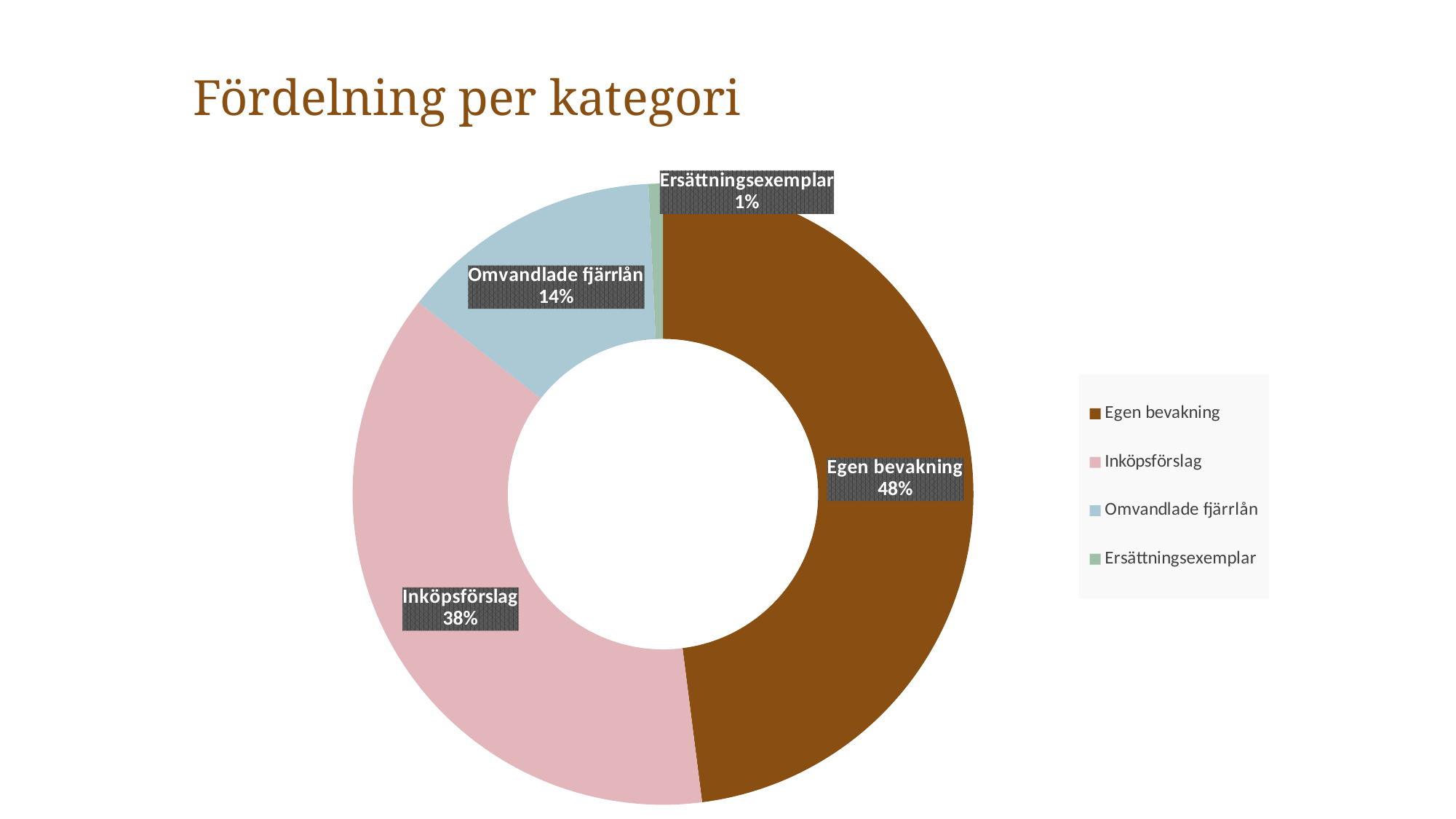
What is the title of the chart? Fördelning per kategori What kind of chart is shown on the slide? Pie chart (doughnut) What is the difference in percentage points between Omvandlade fjärrlån and Ersättningsexemplar? 13 What share of the chart does Egen bevakning represent? 48% Which is larger, Inköpsförslag or Omvandlade fjärrlån? Inköpsförslag Which category has the largest share? Egen bevakning What share of the chart does Omvandlade fjärrlån represent? 14% What is the difference in percentage points between Egen bevakning and Inköpsförslag? 10 What share of the chart does Inköpsförslag represent? 38% How many categories are shown in the chart? 4 Which category has the smallest share? Ersättningsexemplar